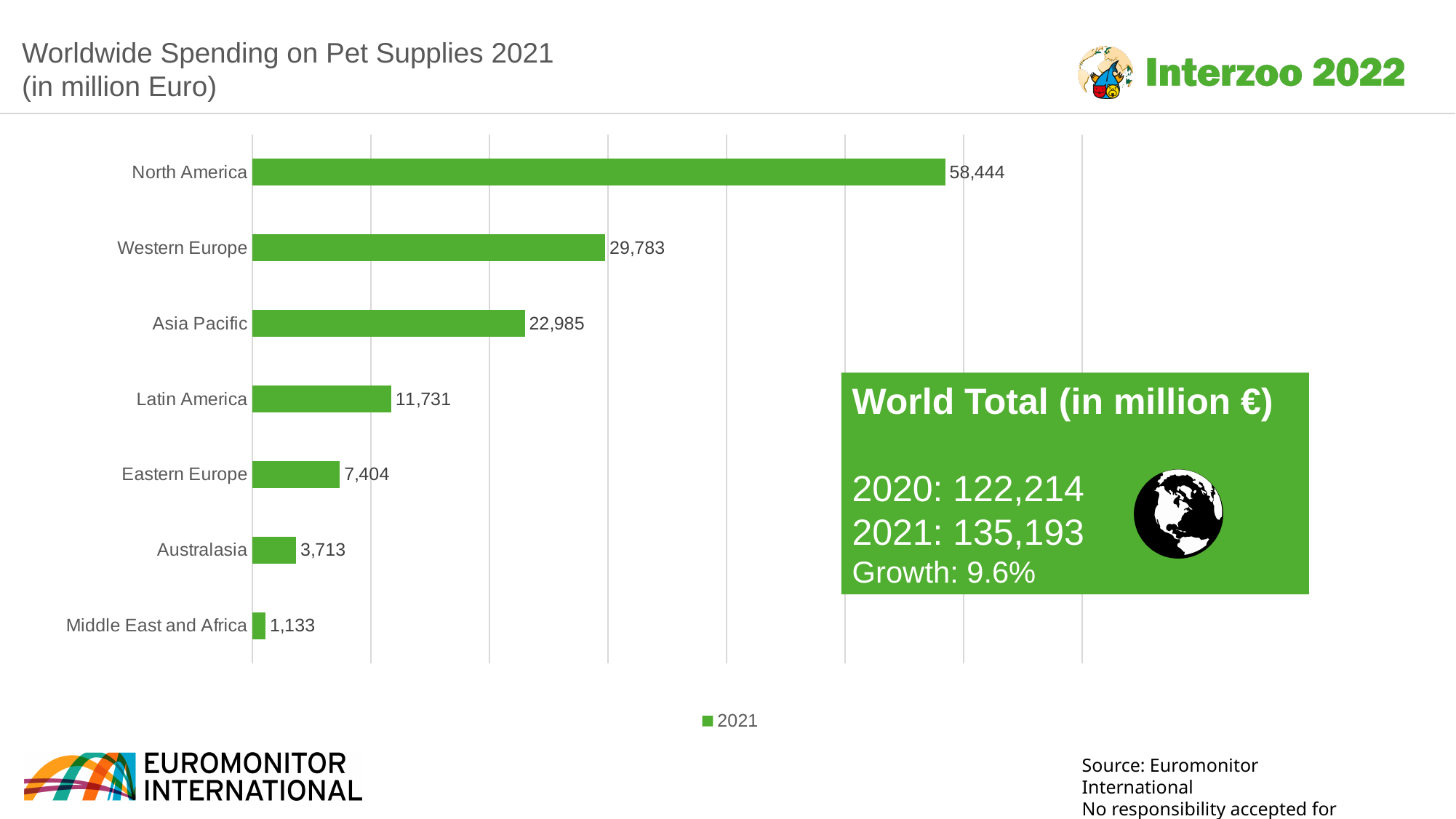
Which is larger, Western Europe or Asia Pacific? Western Europe What is the difference between North America and Western Europe? 28,661 How many series does the legend list? 1 How many regions are shown in the chart? 7 What is the value for Asia Pacific? 22,985 Which region has the lowest spending? Middle East and Africa What is the value for North America? 58,444 What is the value for Middle East and Africa? 1,133 What is the title of the chart? Worldwide Spending on Pet Supplies 2021 (in million Euro) Which region has the highest spending? North America What kind of chart is shown? Bar chart What is the difference between Latin America and Eastern Europe? 4,327